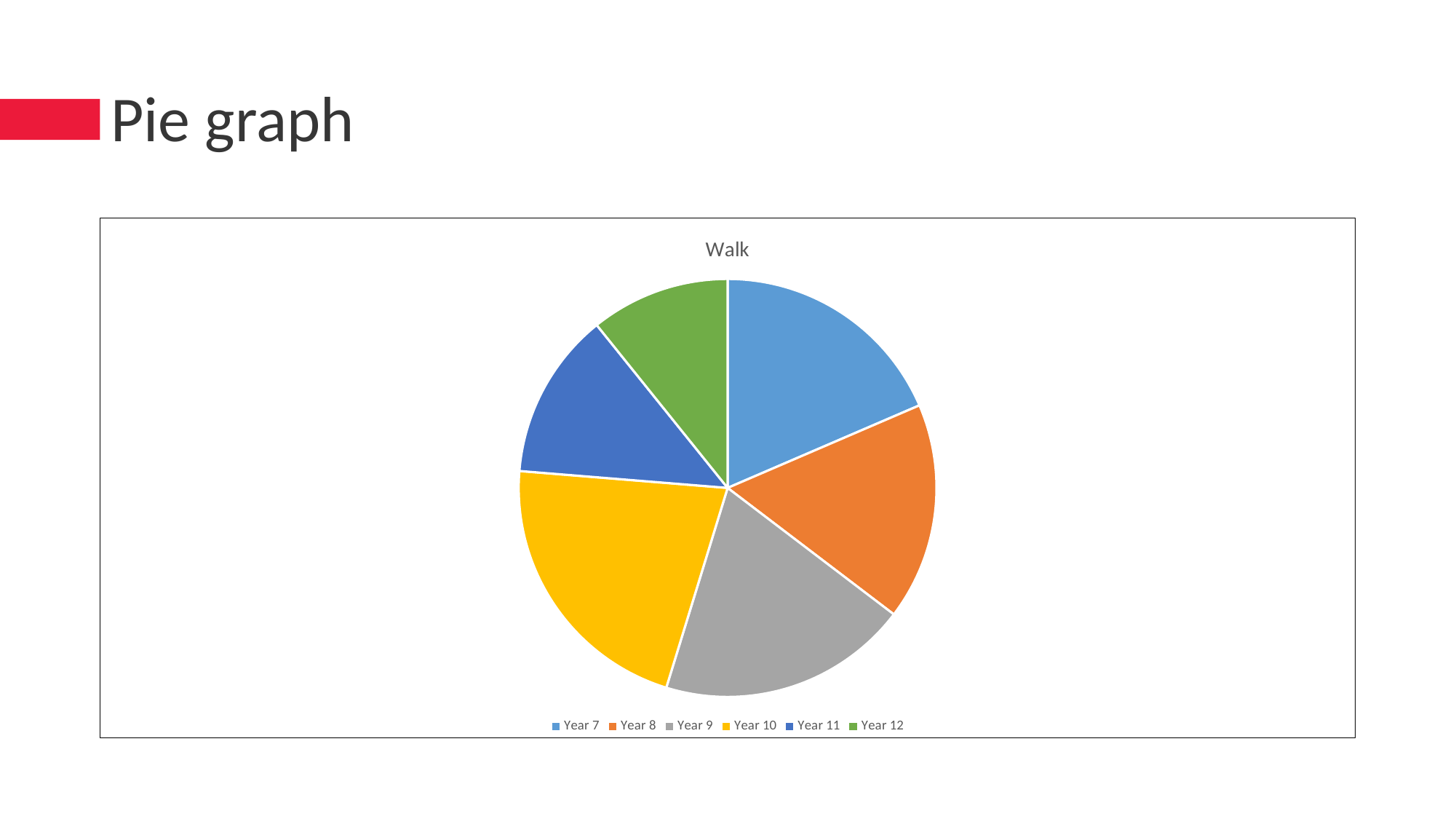
Which category is shown in green in the pie chart? Year 12 How many entries does the legend list? 6 What is the title of the chart? Walk Which slice is larger, Year 7 or Year 12? Year 7 Which category has the smallest slice of the pie? Year 12 What kind of chart is shown on the slide? pie chart Which slice is larger, Year 10 or Year 11? Year 10 Which slice is larger, Year 10 or Year 12? Year 10 How many slices does the pie chart have? 6 Which category has the largest slice of the pie? Year 10